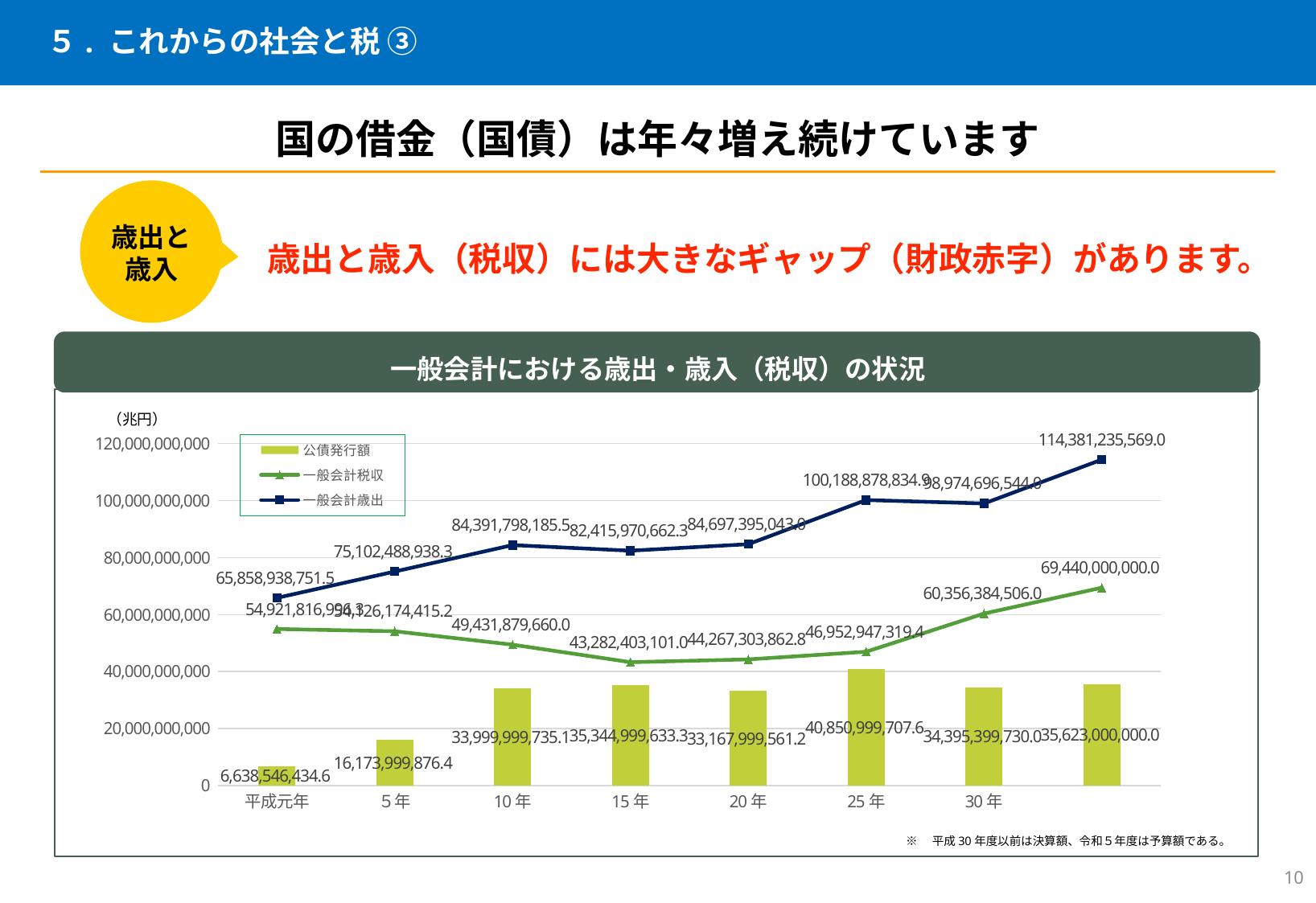
What is the value of 一般会計歳出 for 25年? 100,188,878,834.9 What kind of chart is shown on the slide? A combined bar and line chart For 10年, which is larger: 一般会計歳出 or 一般会計税収? 一般会計歳出 What is the value of 一般会計歳出 for 平成元年? 65,858,938,751.5 What is the difference between 一般会計歳出 and 一般会計税収 for 15年? 39,133,567,561.3 Which labeled year has the lowest 公債発行額 bar? 平成元年 What is the value of 一般会計税収 for 15年? 43,282,403,101.0 Is the value of 一般会計歳出 for 30年 greater or less than 80,000,000,000? greater Which labeled year has the highest 公債発行額 bar? 25年 What is the value of 公債発行額 for 5年? 16,173,999,876.4 What unit is shown at the top of the vertical axis? 兆円 How many series does the chart legend list? 3